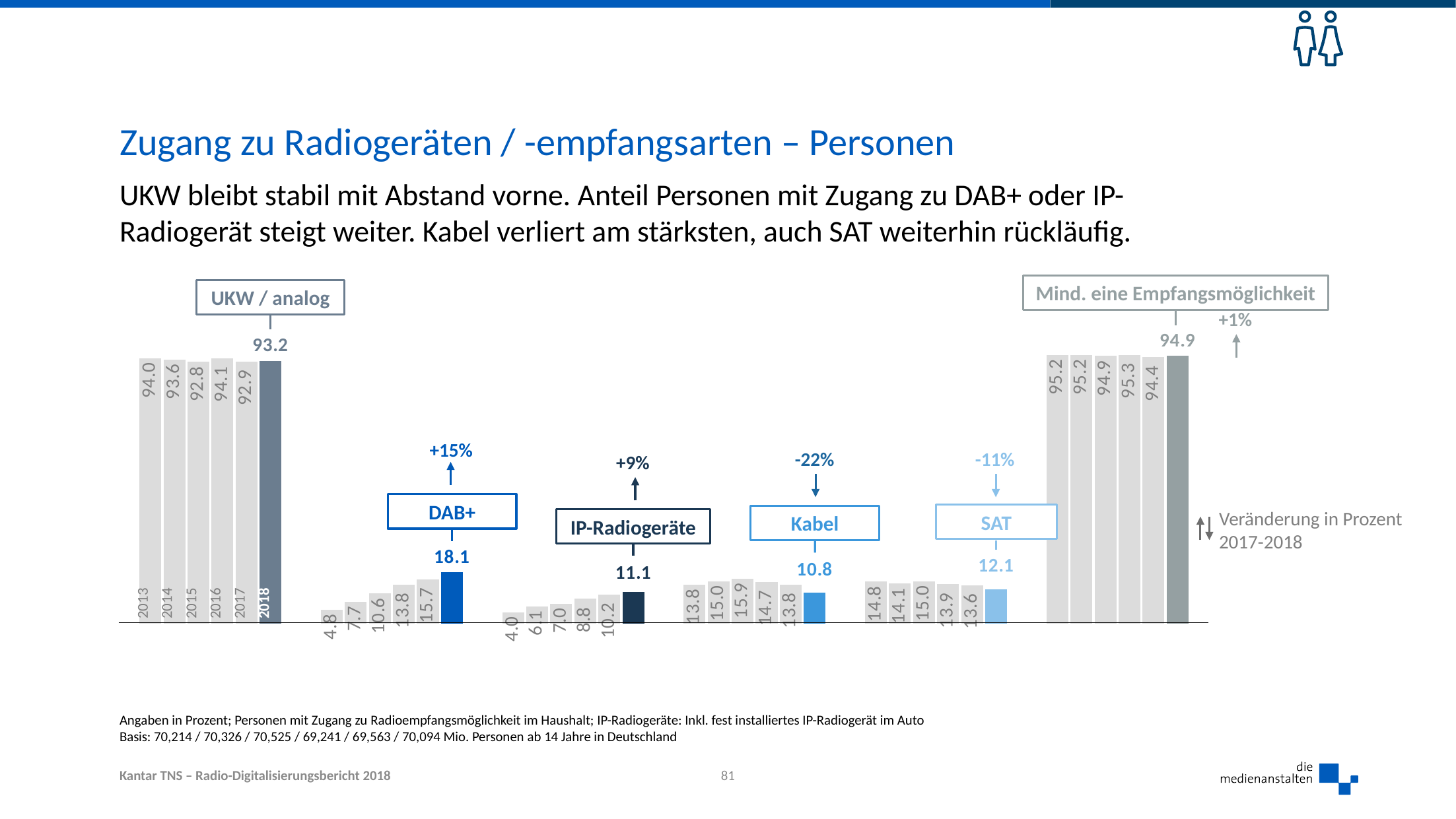
How many years are shown for each group in the chart? 6 Which is larger in 2018, the value for Kabel or the value for SAT? SAT What is the 2018 value for UKW / analog? 93.2 What kind of chart is shown on the slide? bar chart What percentage change from 2017 to 2018 is shown for Kabel? -22% Which year has the lowest value in the SAT group? 2018 Which year has the highest value in the DAB+ group? 2018 What is the difference between the DAB+ values for 2018 and 2017? 2.4 What is the 2018 value for DAB+? 18.1 What is the 2015 value for Kabel? 15.9 Do the values for IP-Radiogeräte rise or fall from 2013 to 2018? rise What is the 2013 value for IP-Radiogeräte? 4.0